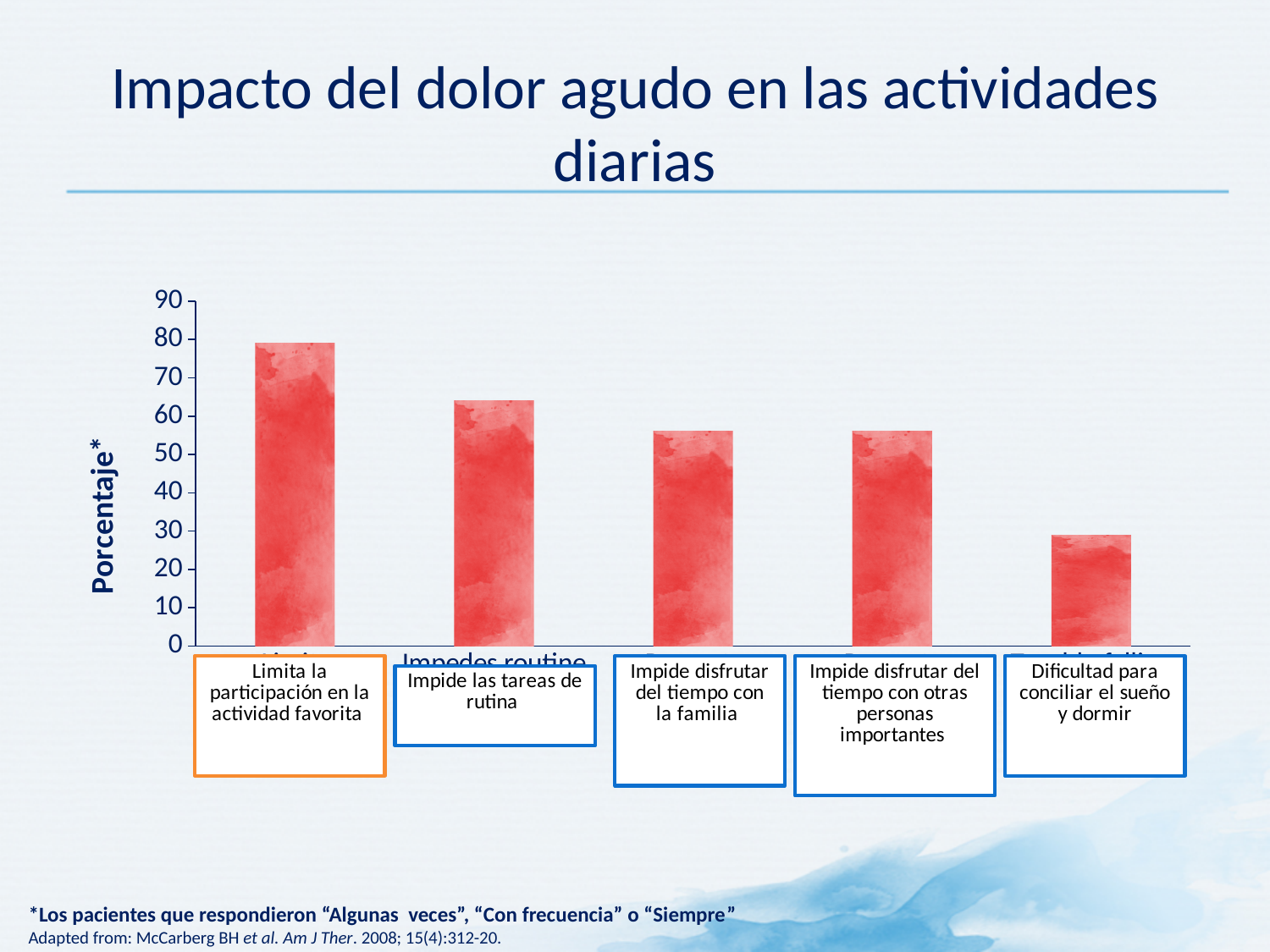
Is the value for "Impide disfrutar del tiempo con la familia" greater or less than 60? less What kind of chart is shown on the slide? bar chart Which is larger, the value for "Impide disfrutar del tiempo con otras personas importantes" or the value for "Dificultad para conciliar el sueño y dormir"? Impide disfrutar del tiempo con otras personas importantes How many categories (bars) does the chart show? 5 Is the value for "Impide las tareas de rutina" greater or less than 60? greater Is the value for "Limita la participación en la actividad favorita" greater or less than 70? greater Which is larger, the value for "Limita la participación en la actividad favorita" or the value for "Impide las tareas de rutina"? Limita la participación en la actividad favorita Which category has the highest value? Limita la participación en la actividad favorita Which category has the lowest value? Dificultad para conciliar el sueño y dormir Do the bar values rise or fall from left to right across the chart? fall What is the label of the vertical axis? Porcentaje*